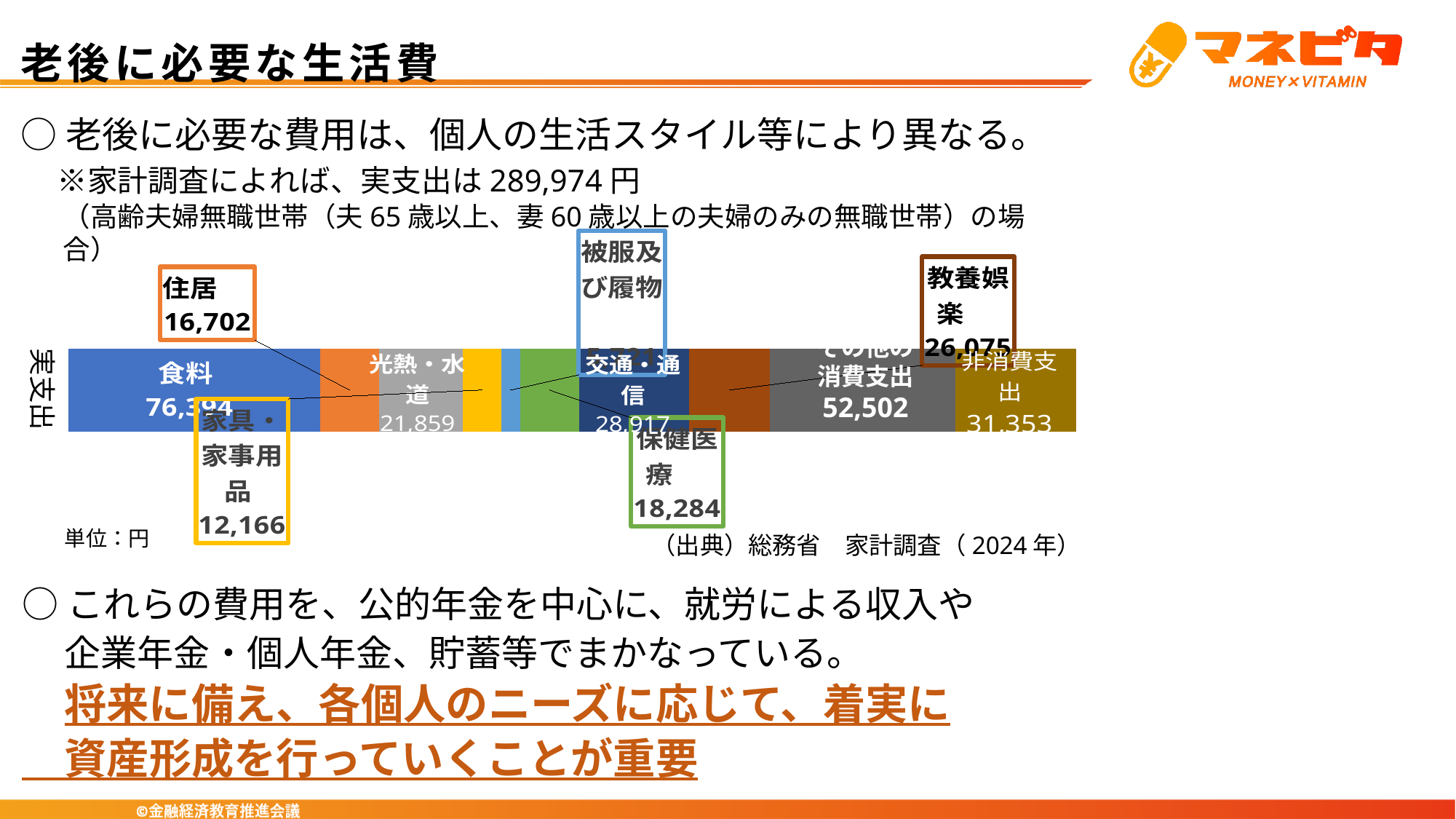
What is the value for 非消費支出 in the chart? 31,353 What is the value for 住居 in the 実支出 stacked bar? 16,702 What is the value for 光熱・水道 in the chart? 21,859 Which is larger in the chart, 教養娯楽 or 保健医療? 教養娯楽 What is the value for その他の消費支出 in the chart? 52,502 What kind of chart is shown on the slide? Stacked bar chart What is the value for 教養娯楽 in the chart? 26,075 What is the value for 保健医療 in the chart? 18,284 What is the value for 交通・通信 in the chart? 28,917 What is the difference between 交通・通信 and 光熱・水道 in the chart? 7,058 What is the value for 家具・家事用品 in the chart? 12,166 Which segment of the 実支出 bar is the largest? 食料